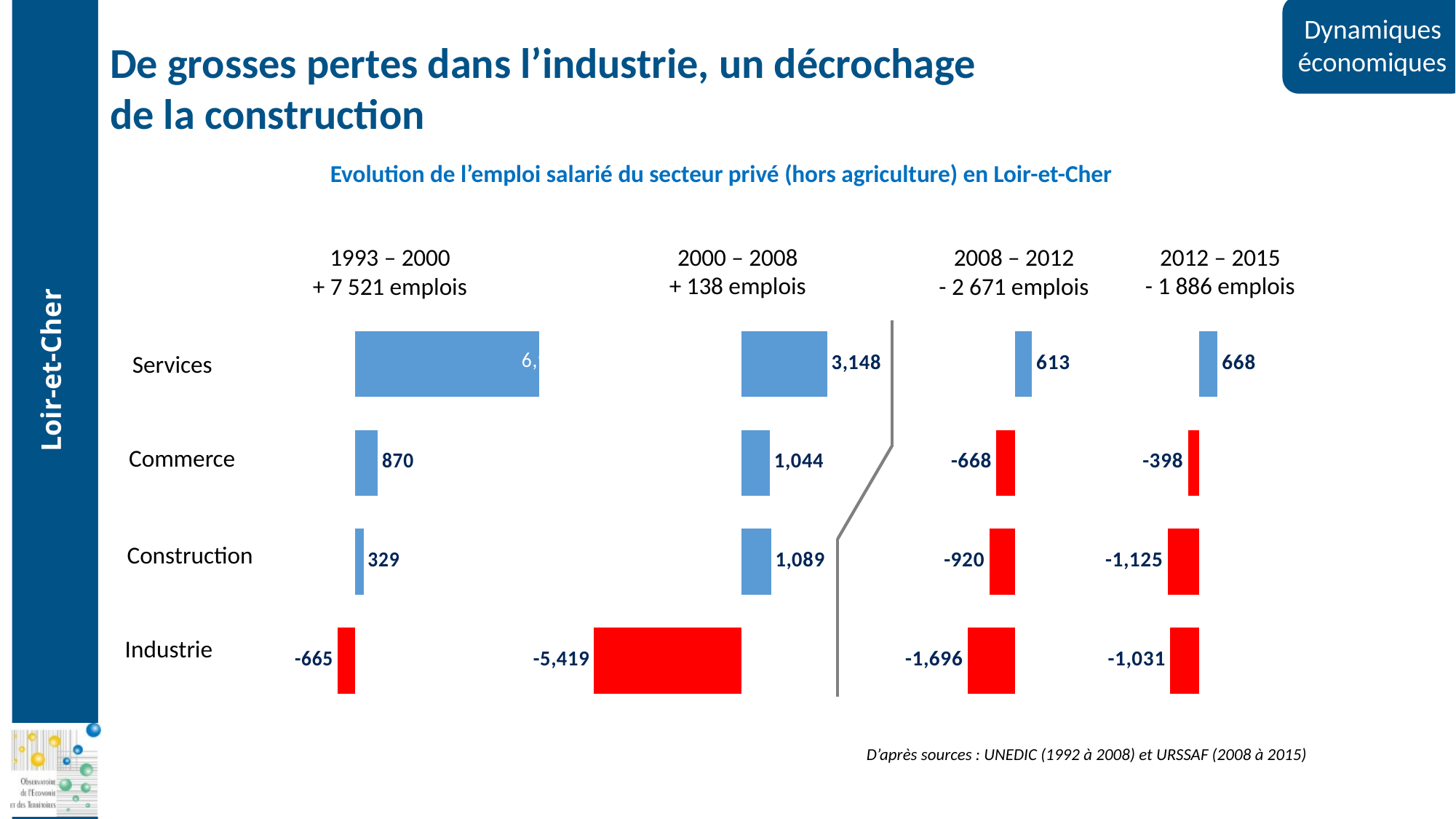
What colour are the bars representing negative values? Red What kind of chart is used to show the employment changes on this slide? Bar chart In the 2008 – 2012 chart, what is the value for Services? 613 In the 2008 – 2012 chart, which sector has the lowest value? Industrie In the 2012 – 2015 chart, which is larger, the value for Commerce or the value for Construction? Commerce In the 1993 – 2000 chart, what is the value for Commerce? 870 In the 2000 – 2008 chart, which sector has the highest value? Services In the 2000 – 2008 chart, what is the value for Industrie? -5,419 In the 2012 – 2015 chart, what is the value for Construction? -1,125 What is the total change in jobs shown for the 2008 – 2012 period? - 2 671 emplois In the 2000 – 2008 chart, what is the difference between the values for Construction and Commerce? 45 How many sectors are shown in each period chart? 4